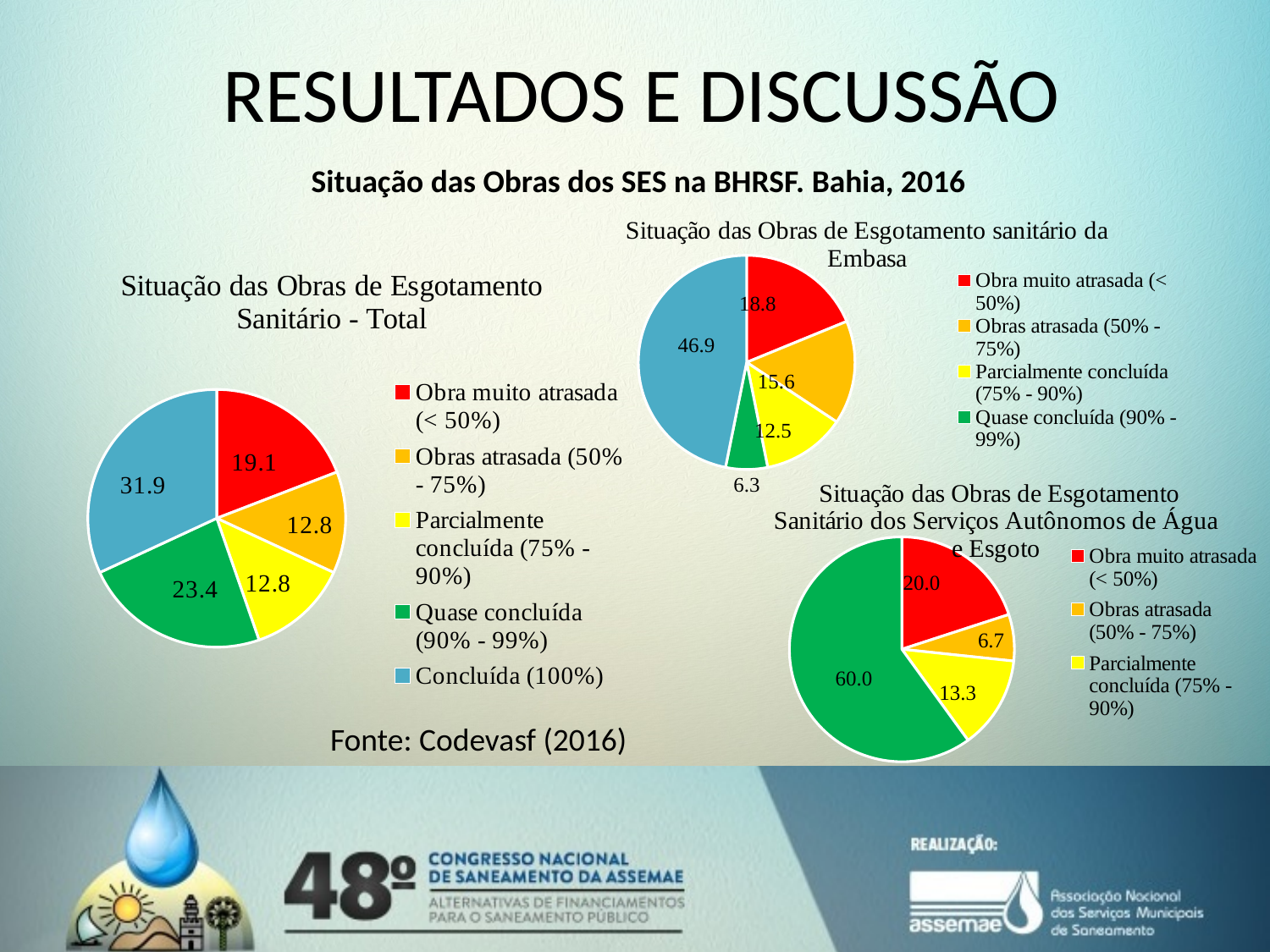
In the chart titled "Situação das Obras de Esgotamento Sanitário dos Serviços Autônomos de Água e Esgoto", which category has the smallest slice? Obras atrasada (50% - 75%) In the chart titled "Situação das Obras de Esgotamento sanitário da Embasa", what is the value of the largest slice? 46.9 In the chart titled "Situação das Obras de Esgotamento sanitário da Embasa", what is the value for "Quase concluída (90% - 99%)"? 6.3 In the chart titled "Situação das Obras de Esgotamento Sanitário dos Serviços Autônomos de Água e Esgoto", what is the difference between the values for "Parcialmente concluída (75% - 90%)" and "Obras atrasada (50% - 75%)"? 6.6 How many entries does the legend of the chart titled "Situação das Obras de Esgotamento Sanitário dos Serviços Autônomos de Água e Esgoto" list? 3 In the chart titled "Situação das Obras de Esgotamento Sanitário dos Serviços Autônomos de Água e Esgoto", what is the value of the green slice? 60.0 In the chart titled "Situação das Obras de Esgotamento Sanitário - Total", which category has the largest slice? Concluída (100%) In the chart titled "Situação das Obras de Esgotamento Sanitário - Total", what is the value for "Quase concluída (90% - 99%)"? 23.4 What type of chart is the chart titled "Situação das Obras de Esgotamento Sanitário - Total"? Pie chart In the chart titled "Situação das Obras de Esgotamento Sanitário - Total", what is the difference between the values for "Concluída (100%)" and "Obra muito atrasada (< 50%)"? 12.8 In the chart titled "Situação das Obras de Esgotamento Sanitário - Total", what is the value for "Concluída (100%)"? 31.9 In the chart titled "Situação das Obras de Esgotamento sanitário da Embasa", which is larger: "Obra muito atrasada (< 50%)" or "Obras atrasada (50% - 75%)"? Obra muito atrasada (< 50%)